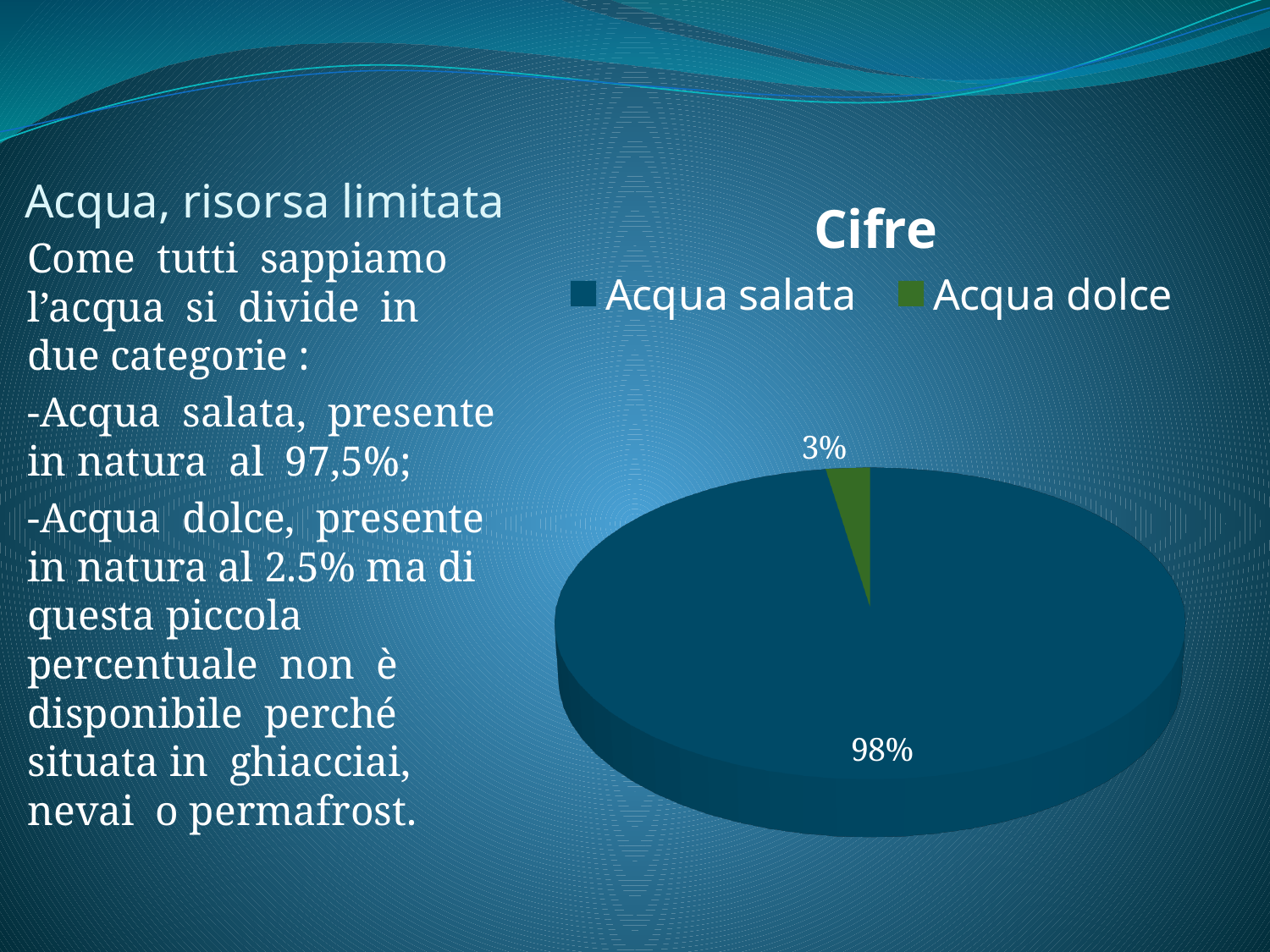
What share of the pie does Acqua salata have? 98% Which category has the largest slice of the pie? Acqua salata What is the title of the chart? Cifre Which category has the smallest slice of the pie? Acqua dolce What share of the pie does Acqua dolce have? 3% What is the difference in percentage points between the Acqua salata slice and the Acqua dolce slice? 95 Which is larger, the slice for Acqua salata or the slice for Acqua dolce? Acqua salata Which category is shown in green in the legend? Acqua dolce How many categories does the pie chart show? 2 What kind of chart is shown on the slide? pie chart